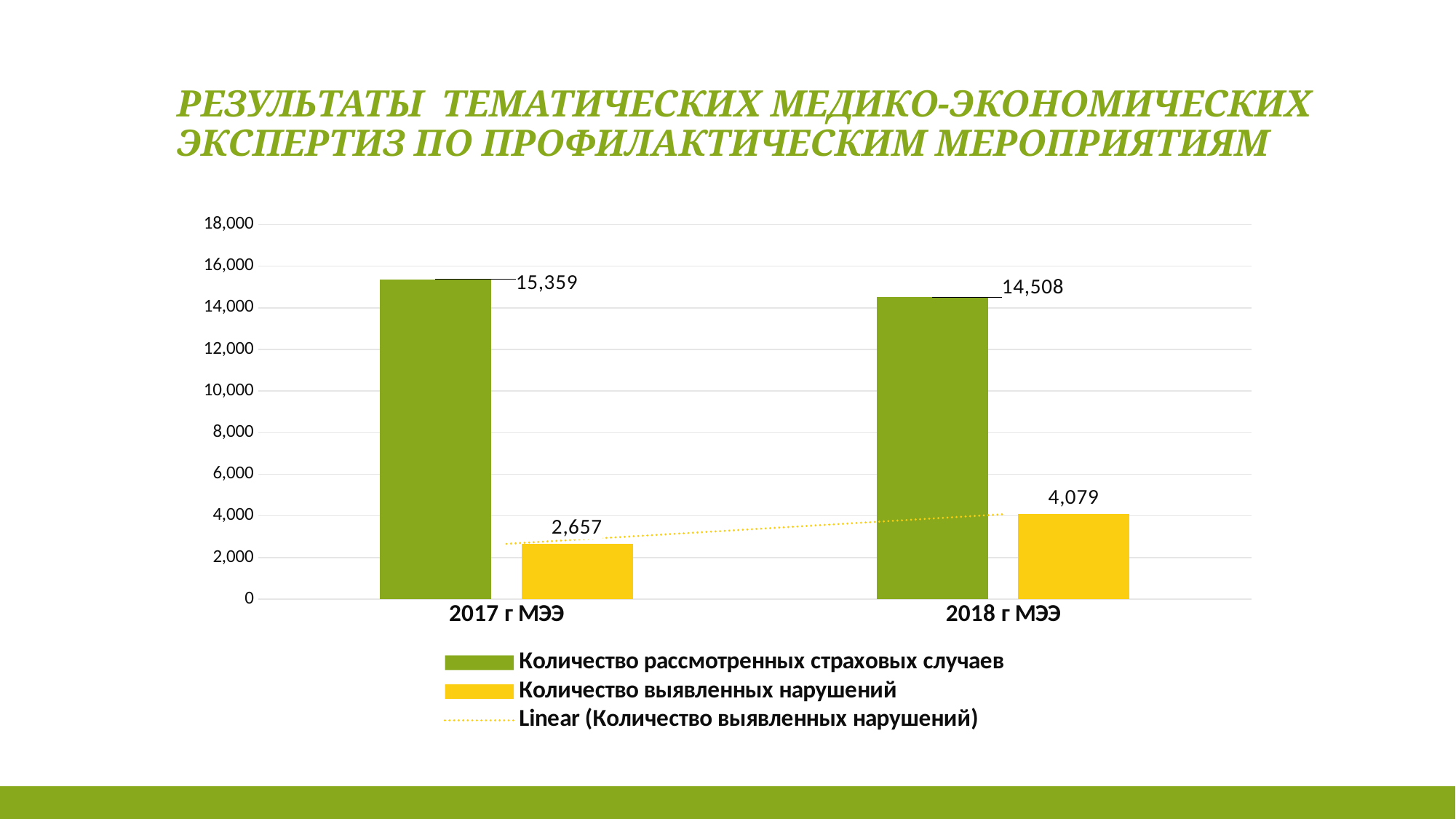
Is Количество выявленных нарушений larger in 2017 г МЭЭ or 2018 г МЭЭ? 2018 г МЭЭ What kind of chart is shown on the slide? Bar chart Which category has the lower value for Количество выявленных нарушений? 2017 г МЭЭ What is the value of Количество рассмотренных страховых случаев for 2017 г МЭЭ? 15,359 What is the value of Количество рассмотренных страховых случаев for 2018 г МЭЭ? 14,508 What is the difference between Количество рассмотренных страховых случаев in 2017 г МЭЭ and 2018 г МЭЭ? 851 How many categories are shown on the x axis? 2 By how much did Количество выявленных нарушений increase from 2017 г МЭЭ to 2018 г МЭЭ? 1,422 What is the value of Количество выявленных нарушений for 2017 г МЭЭ? 2,657 Which category has the higher value for Количество рассмотренных страховых случаев? 2017 г МЭЭ What is the value of Количество выявленных нарушений for 2018 г МЭЭ? 4,079 How many entries does the legend list? 3